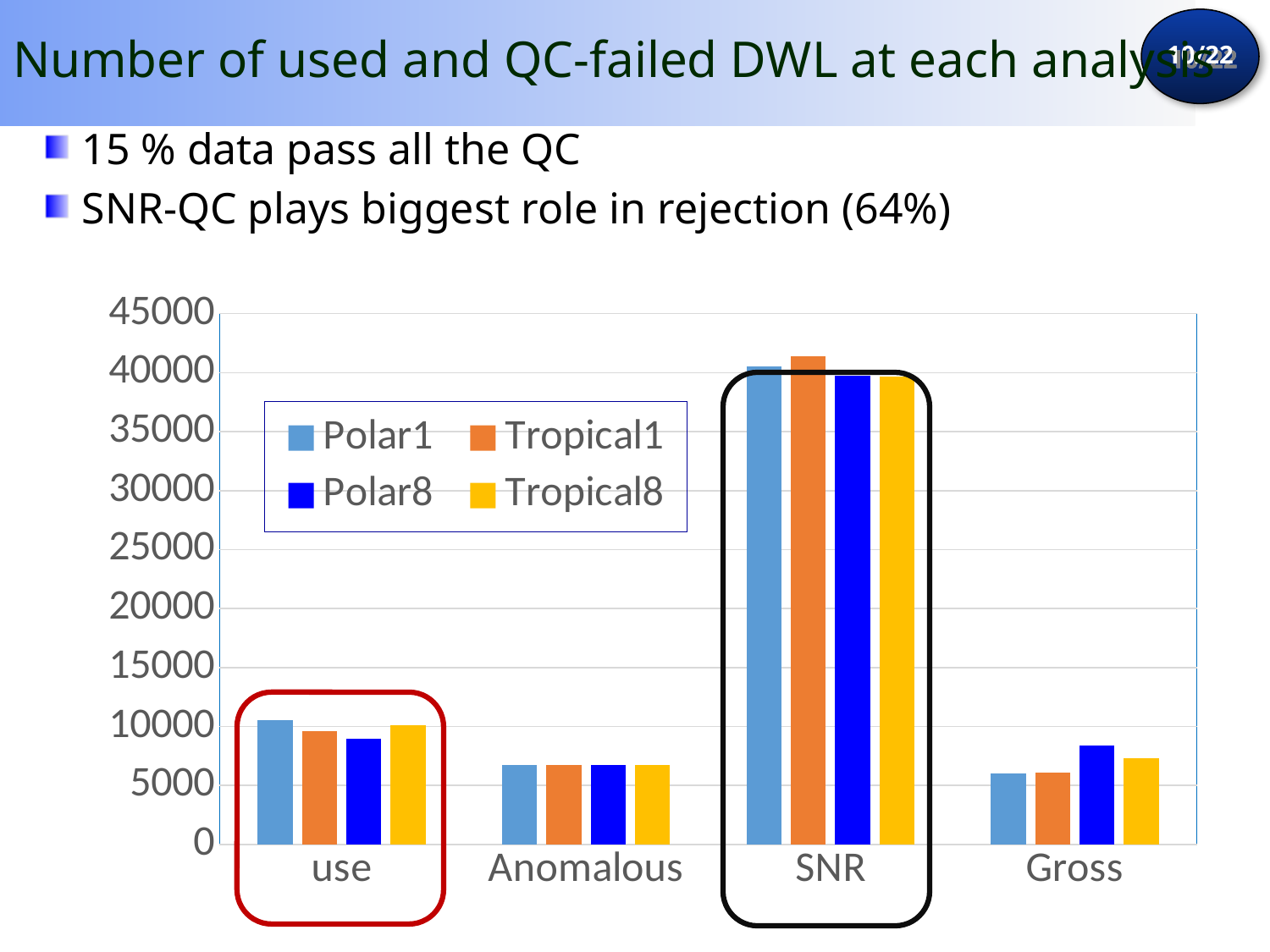
Which is larger for the Polar8 series: the Gross value or the Anomalous value? Gross Is the value for Polar8 in the Gross category greater or less than 5000? greater How many series does the chart's legend list? 4 For the Polar8 series, which category has the lowest value? Anomalous Which series is shown in yellow in the chart's legend? Tropical8 Is the value for Tropical1 in the SNR category greater or less than 40000? greater Is the value for Polar8 in the use category greater or less than 10000? less Within the SNR category, which series has the tallest bar? Tropical1 How many categories are shown on the x axis of the chart? 4 Which is larger: the Polar1 value for use or the Polar8 value for use? Polar1 What kind of chart is shown on the slide? bar chart Which category has the highest values in the chart? SNR